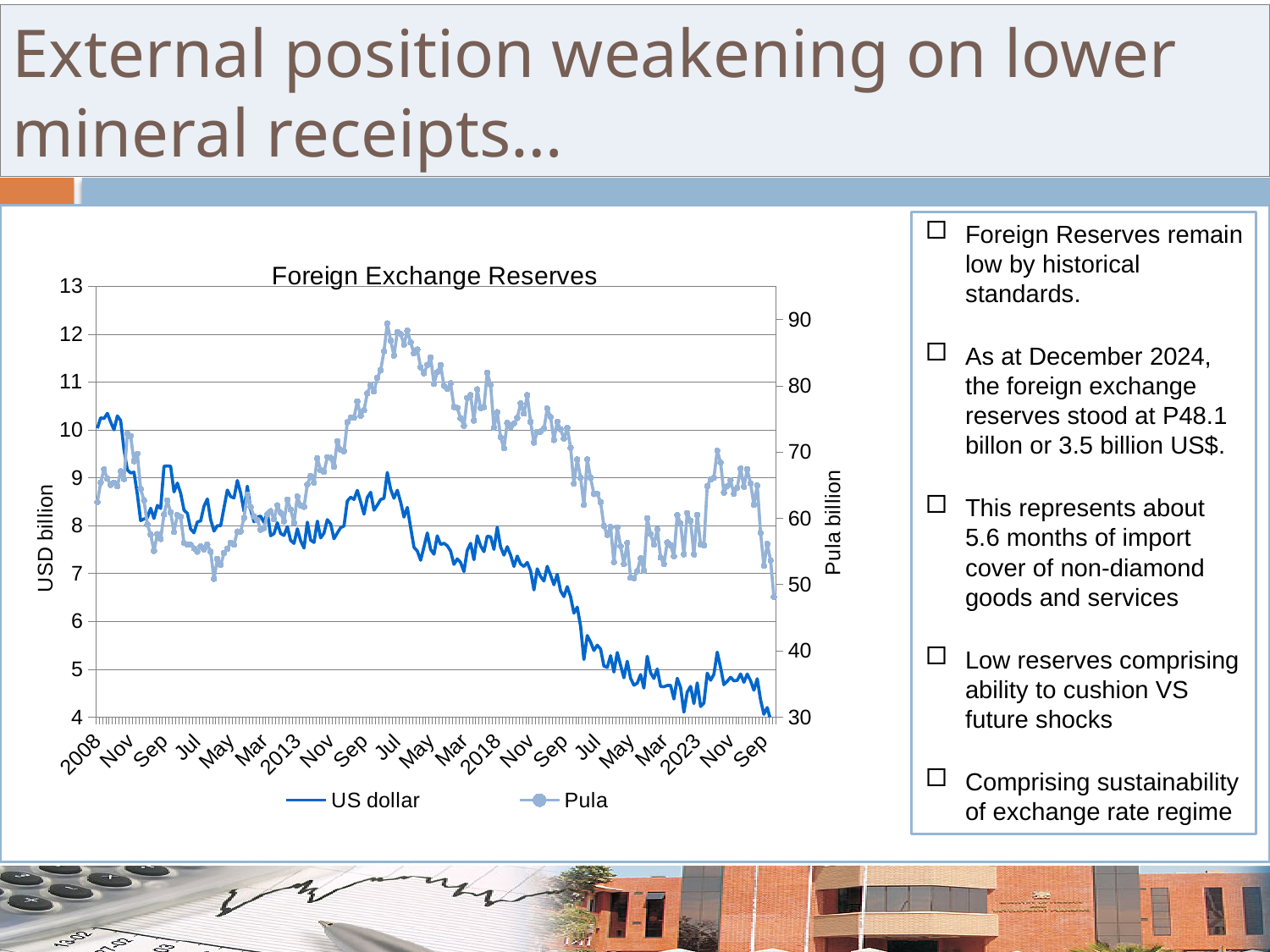
In the Foreign Exchange Reserves chart, is the US dollar value higher at the start of the series in 2008 or at the end in Sep 2024? 2008 Over the whole period shown, does the US dollar series in the Foreign Exchange Reserves chart generally rise or fall? fall How many series does the legend of the Foreign Exchange Reserves chart list? 2 What kind of chart is the Foreign Exchange Reserves chart? line chart In the Foreign Exchange Reserves chart, is the Pula value at the end of the series (Sep 2024) greater or less than 60 Pula billion? less What is the label of the left vertical axis of the Foreign Exchange Reserves chart? USD billion From 2018 to 2023, does the US dollar series in the Foreign Exchange Reserves chart rise or fall? fall In the Foreign Exchange Reserves chart, is the US dollar value at the start of the series in 2008 greater or less than 9? greater What are the two series shown in the legend of the Foreign Exchange Reserves chart? US dollar and Pula In the Foreign Exchange Reserves chart, is the US dollar value at the end of the series (Sep 2024) greater or less than 5? less